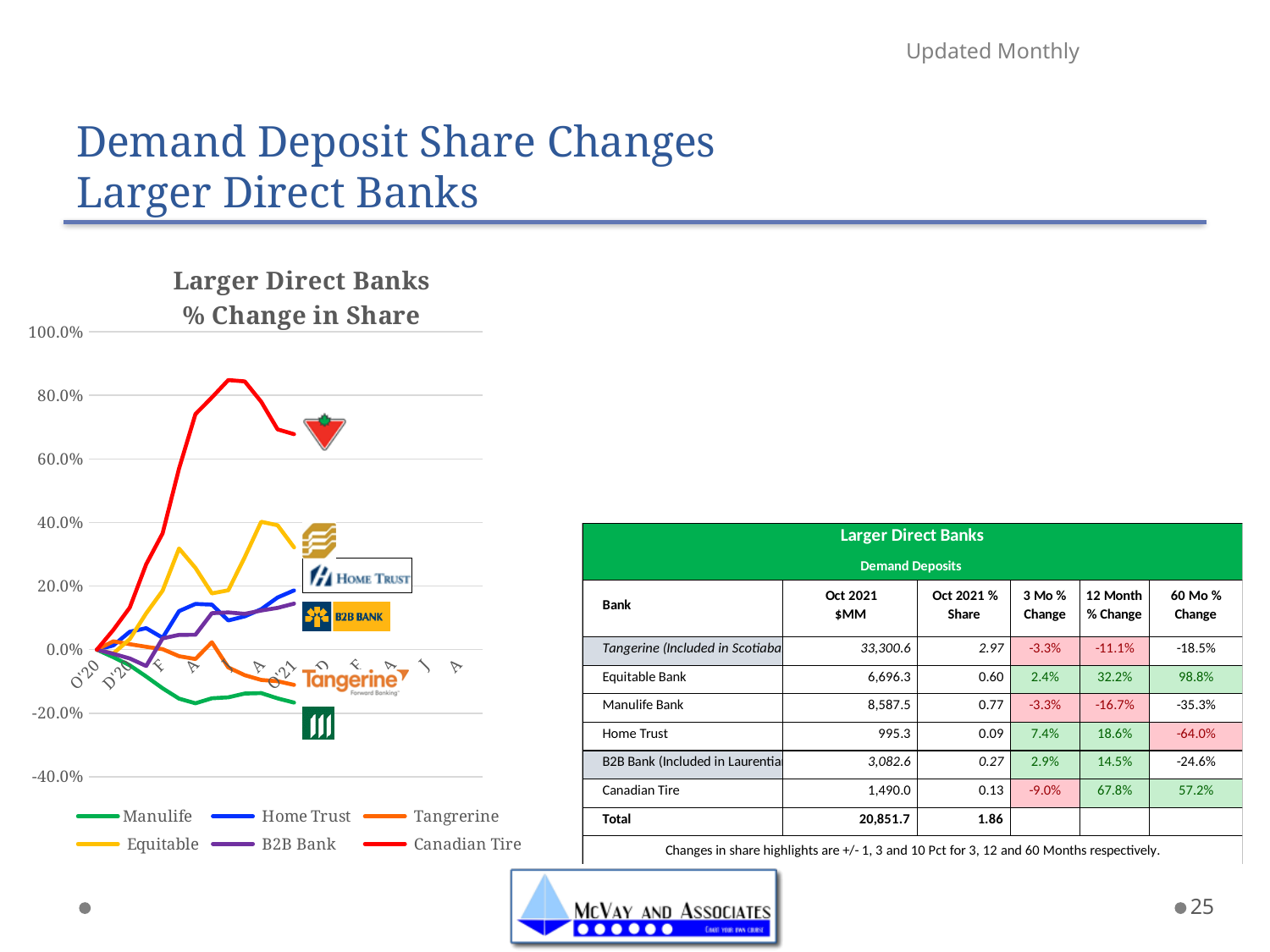
Is the peak value for Equitable greater or less than 20.0%? greater Is the lowest value for Manulife greater or less than 0.0%? less Which series reaches the lowest value on the chart? Manulife What colour is the Canadian Tire line in the chart? Red Is the peak value for Canadian Tire greater or less than 60.0%? greater At the right end of the chart, which is higher: Canadian Tire or Manulife? Canadian Tire How many series does the chart legend list? 6 Which series reaches the highest value on the chart? Canadian Tire What is the title of the chart? Larger Direct Banks % Change in Share Does the Canadian Tire line overall rise or fall from the start to the end of the chart? Rise Does the Manulife line overall rise or fall from the start to the end of the chart? Fall What kind of chart is shown on the slide? Line chart